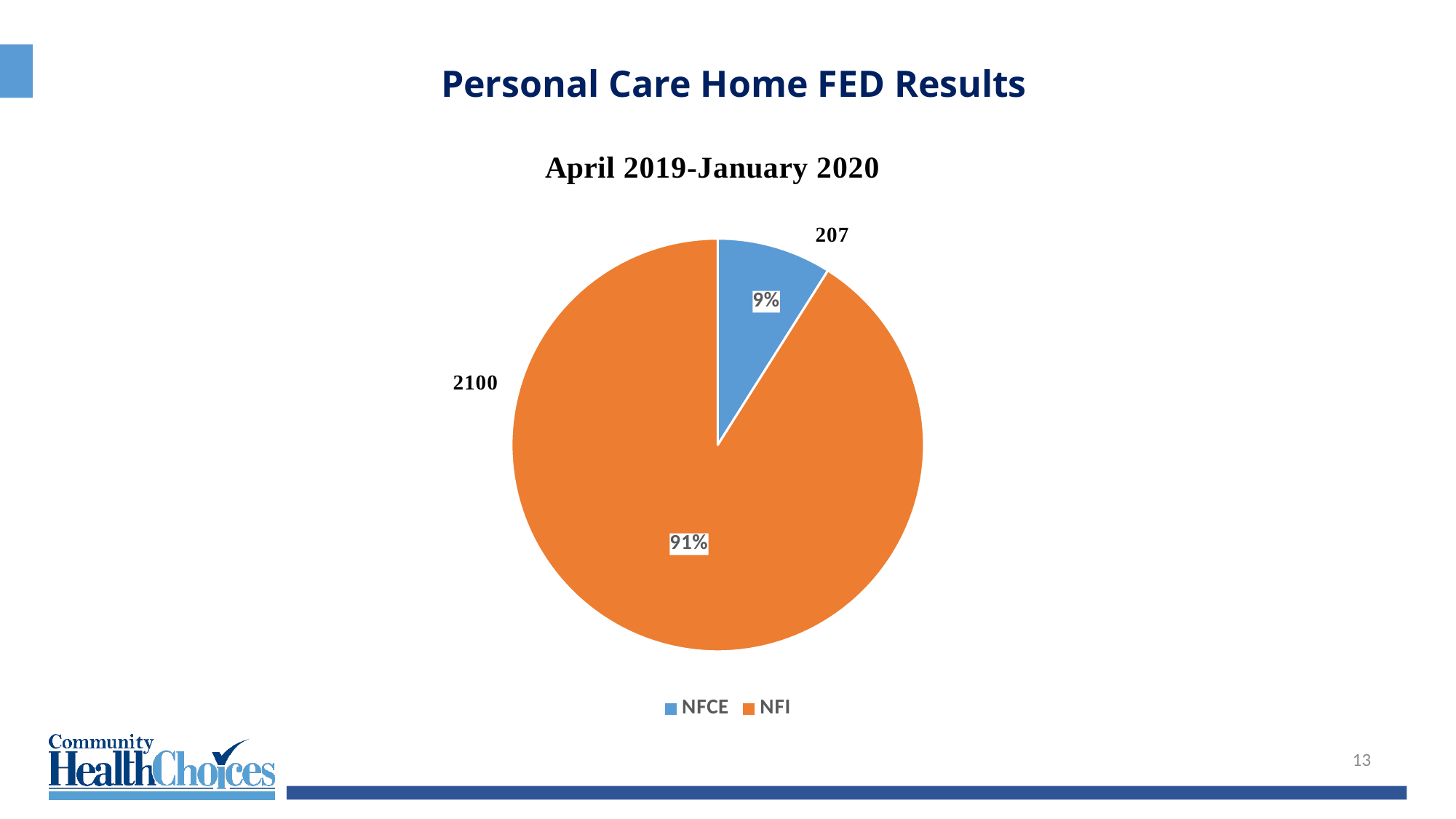
Which category has the smallest slice? NFCE What is the chart's title? April 2019-January 2020 What is the value for NFI? 2100 How many categories does the legend list? 2 What share of the pie does NFCE represent? 9% What share of the pie does NFI represent? 91% What kind of chart is shown on the slide? pie chart Which category has the largest slice? NFI Which is larger, NFCE or NFI? NFI What is the difference between the NFI and NFCE values? 1893 What is the value for NFCE? 207 What colour is the NFI slice? orange